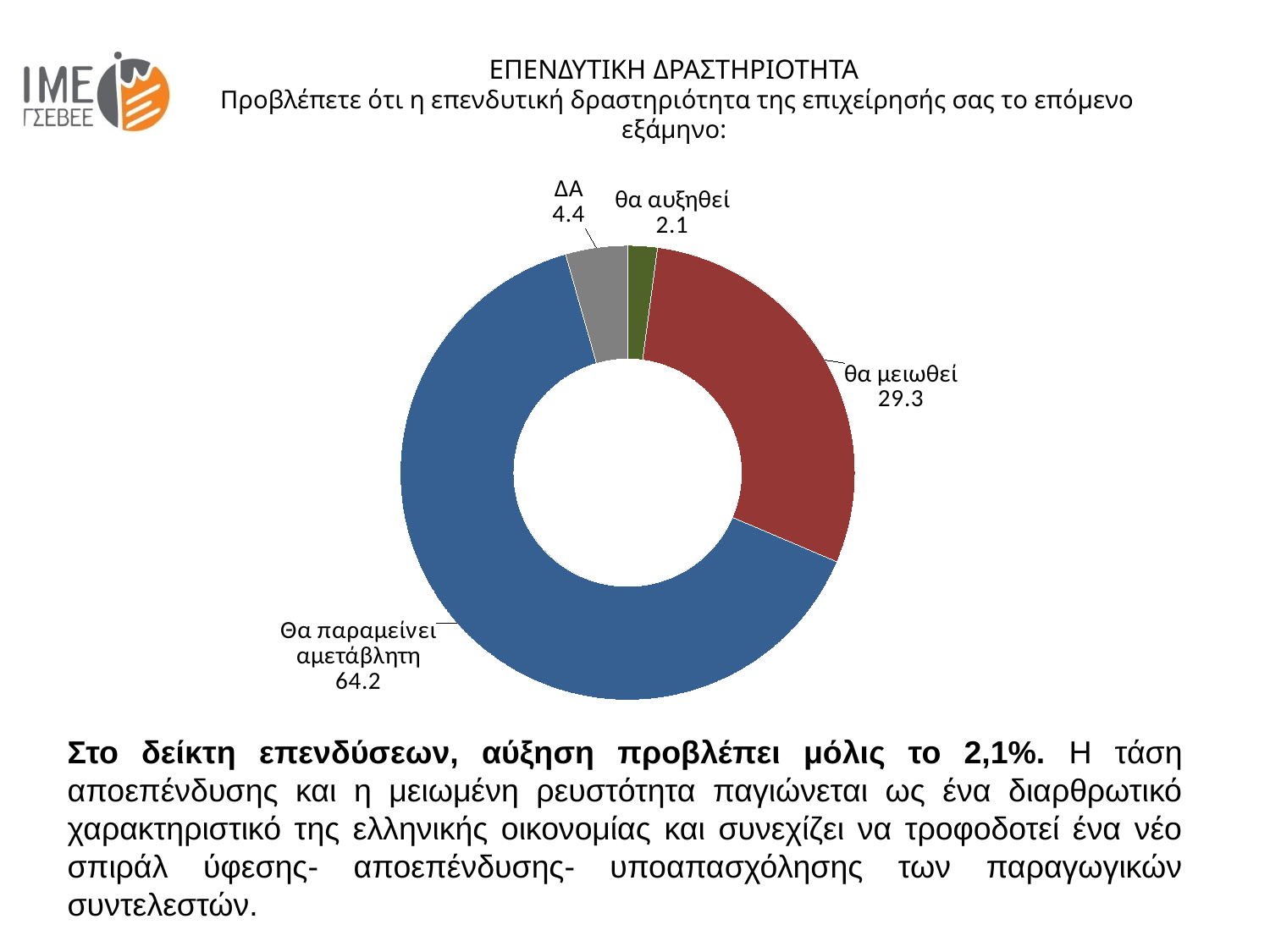
What kind of chart is shown on the slide? Doughnut (pie) chart Which category has the smallest slice? θα αυξηθεί What value is shown for the slice labelled "ΔΑ"? 4.4 What value is shown for the slice labelled "θα μειωθεί"? 29.3 What value is shown for the slice labelled "θα αυξηθεί"? 2.1 How many slices does the chart have? 4 Which category has the largest slice? Θα παραμείνει αμετάβλητη What colour is the slice for "θα μειωθεί"? Red What is the difference between the values for "Θα παραμείνει αμετάβλητη" and "θα μειωθεί"? 34.9 What is the difference between the values for "θα μειωθεί" and "ΔΑ"? 24.9 What value is shown for the slice labelled "Θα παραμείνει αμετάβλητη"? 64.2 Which is larger, the value for "ΔΑ" or the value for "θα αυξηθεί"? ΔΑ